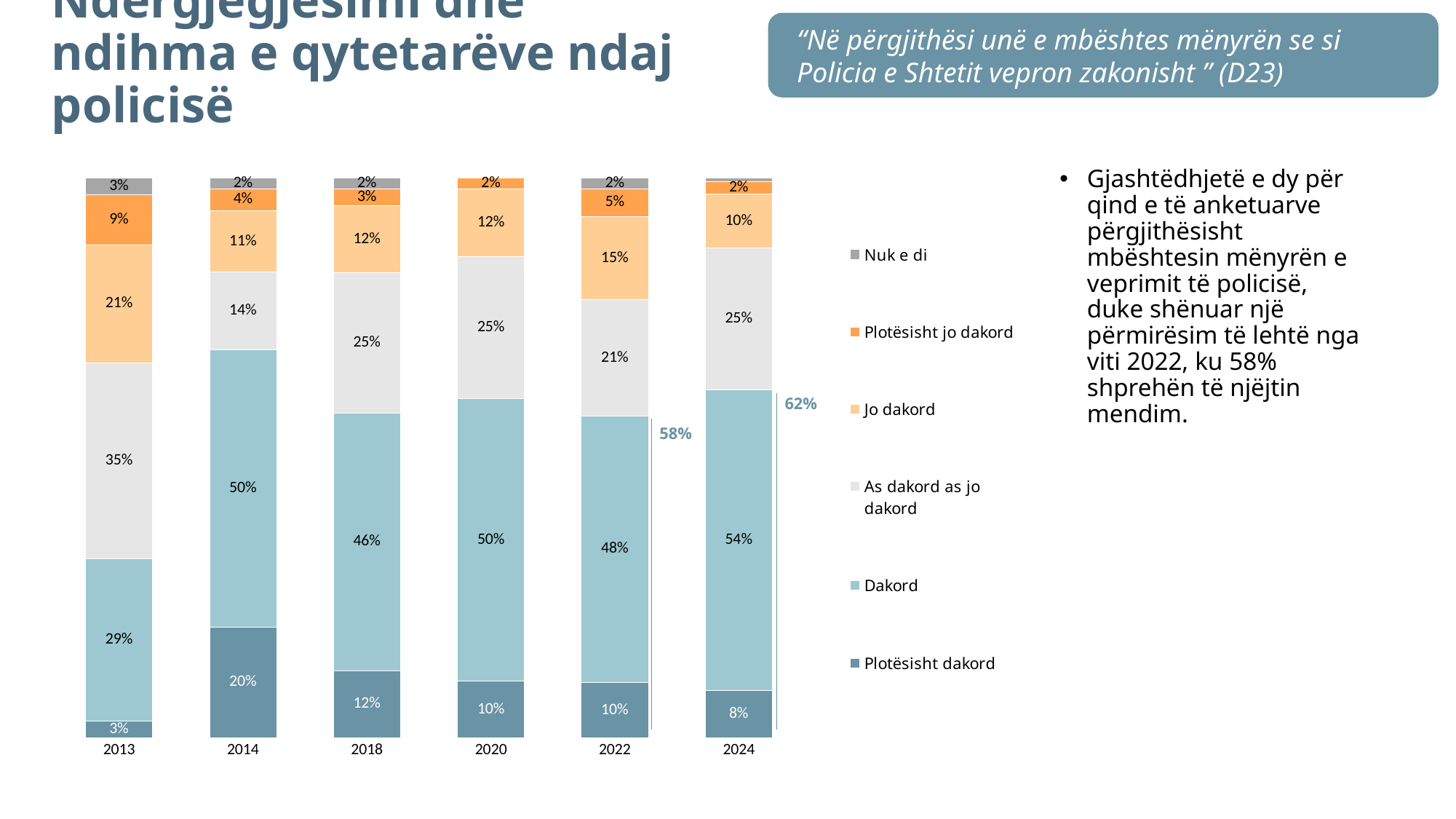
What is the value for Dakord in 2024? 54% What is the value for Plotësisht dakord in 2014? 20% What type of chart is shown on the slide? stacked bar chart In which year is the Plotësisht dakord value highest? 2014 What is the difference between the Dakord values for 2024 and 2022? 6% What combined percentage is annotated next to the 2024 bar? 62% What is the value for As dakord as jo dakord in 2013? 35% What is the value for Jo dakord in 2022? 15% Which is larger, the Jo dakord value in 2013 or in 2018? 2013 How many years are shown on the x axis of the chart? 6 How many series does the legend list? 6 In which year is the Dakord value lowest? 2013